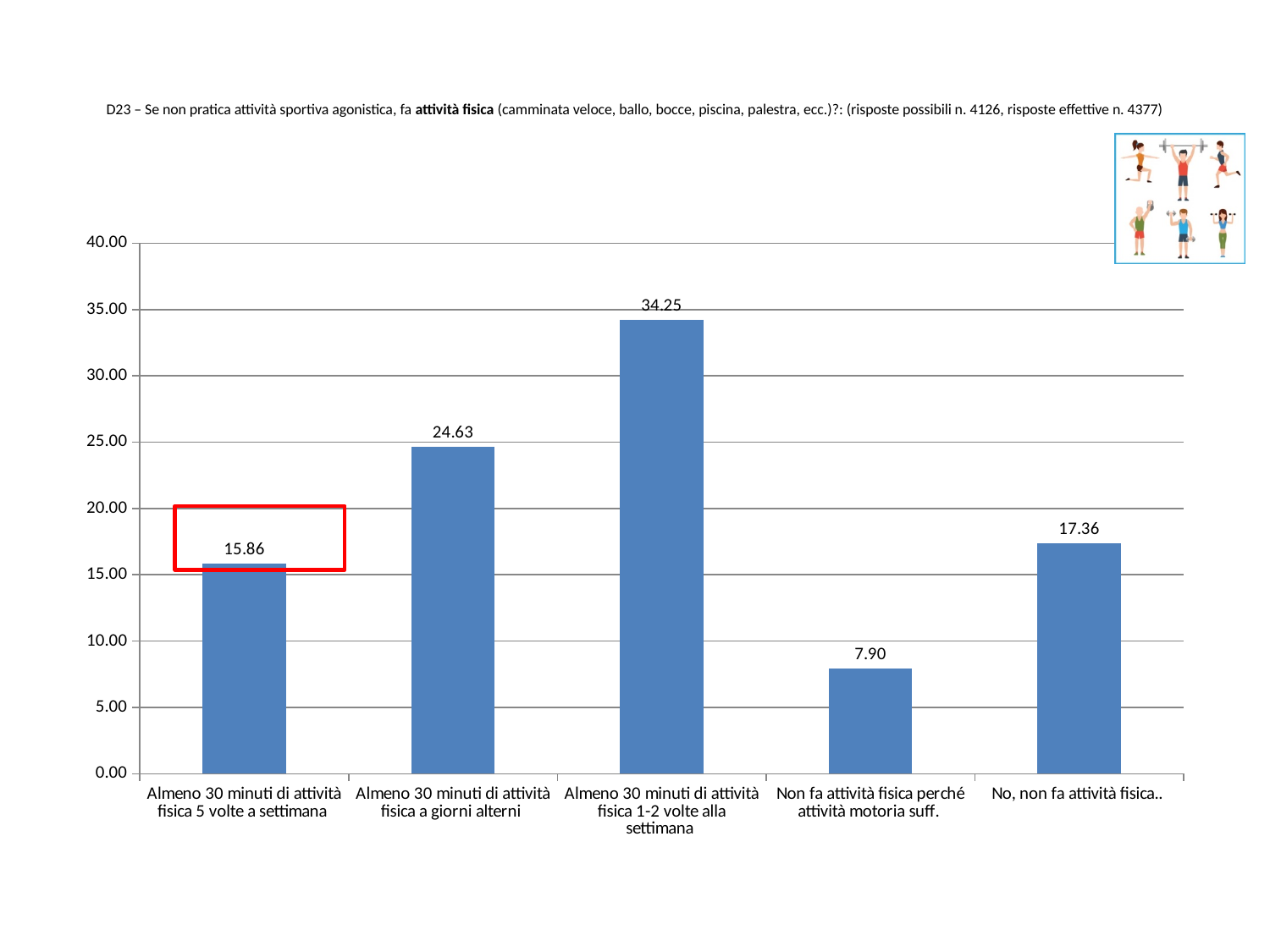
Which category has the highest value? Almeno 30 minuti di attività fisica 1-2 volte alla settimana Which category has the lowest value? Non fa attività fisica perché attività motoria suff. Which is larger: the value for "No, non fa attività fisica.." or the value for "Almeno 30 minuti di attività fisica 5 volte a settimana"? No, non fa attività fisica.. What is the value for "No, non fa attività fisica.."? 17.36 How many categories are shown on the chart? 5 What kind of chart is shown on the slide? bar chart What is the value for "Almeno 30 minuti di attività fisica 5 volte a settimana"? 15.86 What is the value for "Non fa attività fisica perché attività motoria suff."? 7.90 Which bar is outlined with a red rectangle? Almeno 30 minuti di attività fisica 5 volte a settimana What is the value for "Almeno 30 minuti di attività fisica a giorni alterni"? 24.63 What is the difference between the values for "Almeno 30 minuti di attività fisica 1-2 volte alla settimana" and "Almeno 30 minuti di attività fisica a giorni alterni"? 9.62 Is the value for "Almeno 30 minuti di attività fisica a giorni alterni" greater or less than 20.00? greater